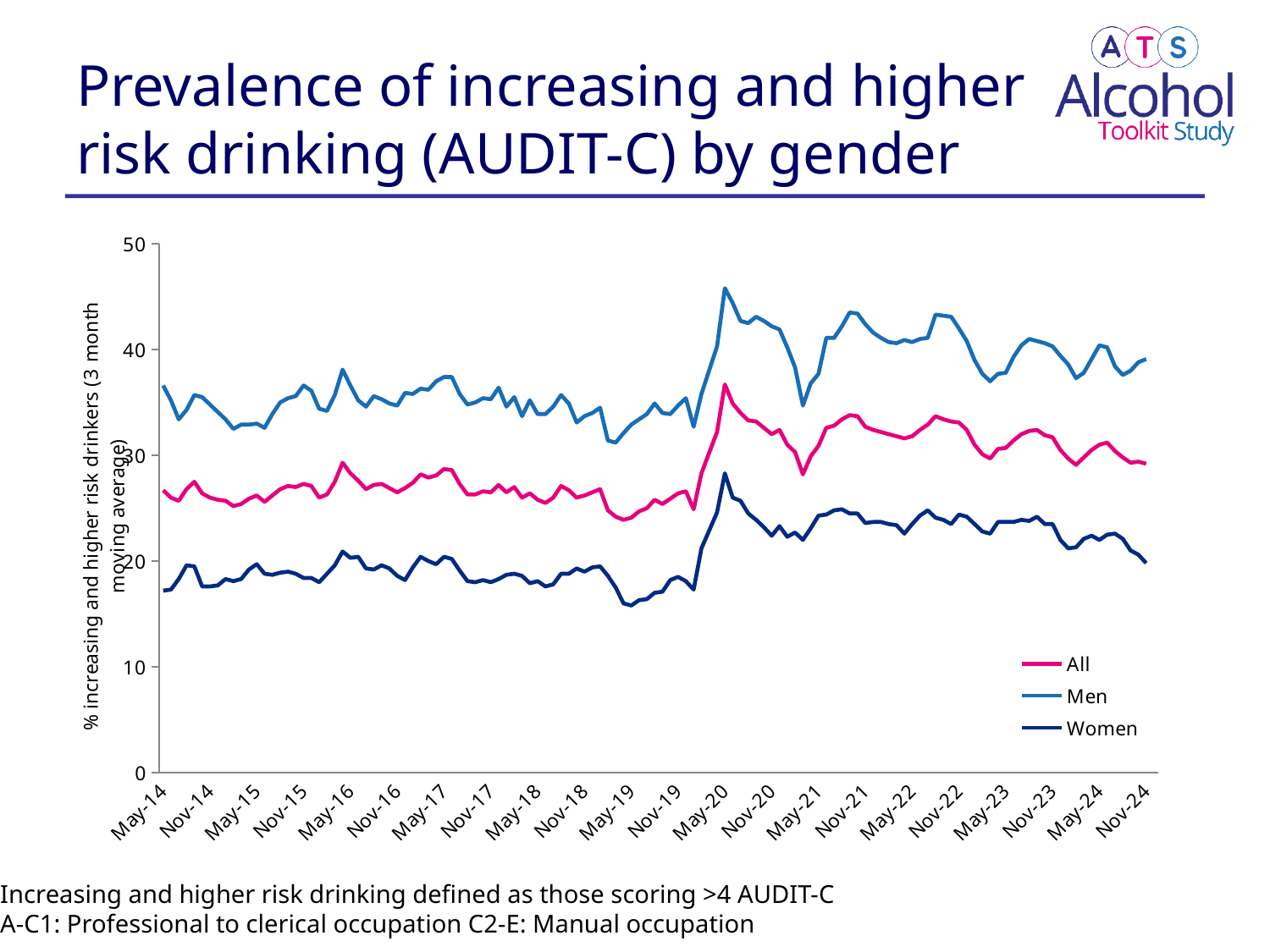
How many date labels are shown on the x axis? 22 Which series is plotted highest across the whole period? Men Is the value for Women at May-22 greater or less than 20? greater Is the value for Men at May-20 greater or less than 40? greater What colour is the line for the All series? Pink Which series is plotted lowest across the whole period? Women Between May-20 and Nov-24, does the All line overall rise or fall? fall What kind of chart is shown on the slide? Line chart How many series does the legend list? 3 Between Nov-19 and May-20, does the Men line rise or fall? rise Is the value for Women at May-19 greater or less than 20? less